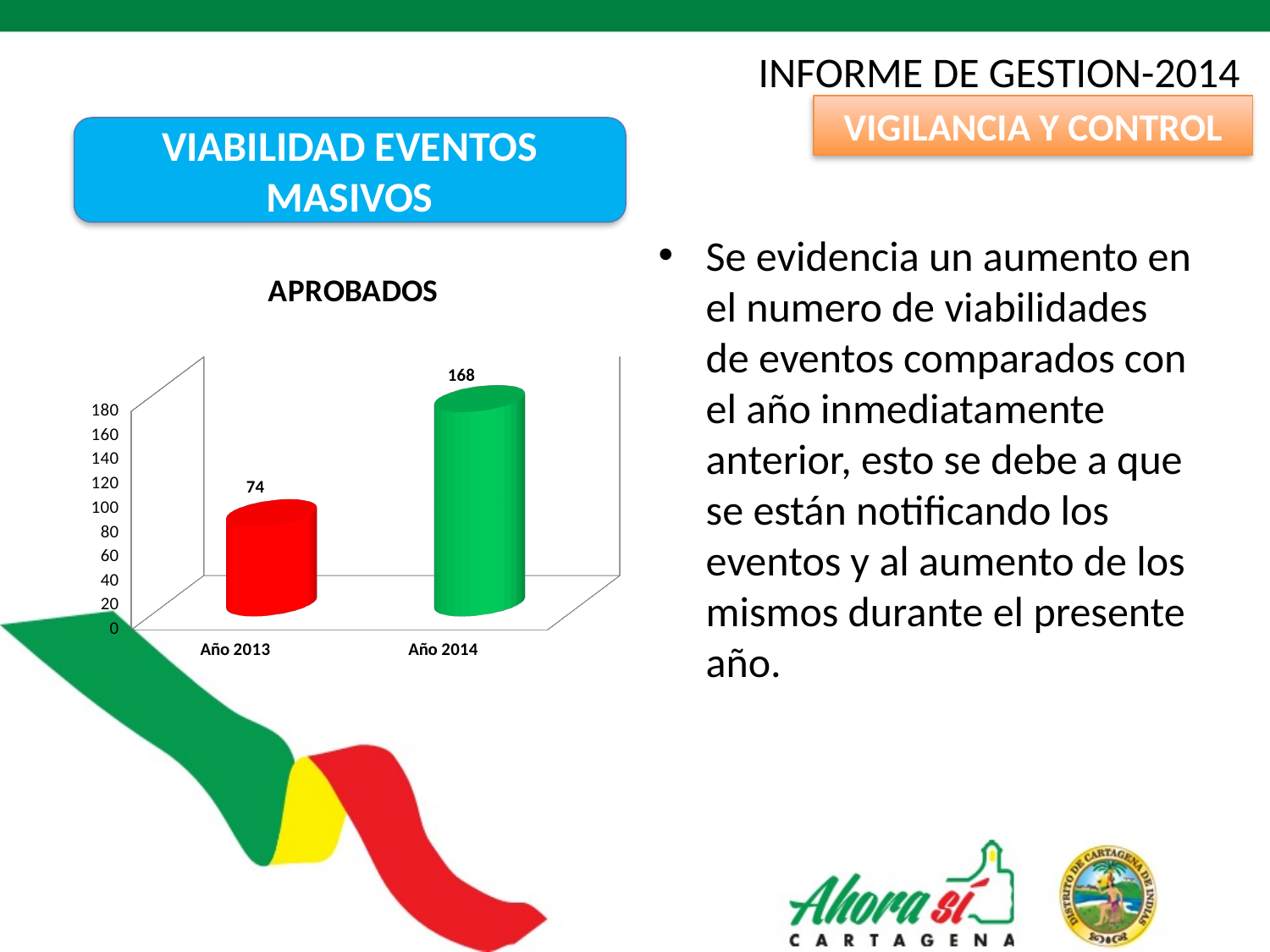
What is the value for Año 2014 in the APROBADOS chart? 168 Which year has the lowest value in the APROBADOS chart? Año 2013 Which is larger in the APROBADOS chart, the value for Año 2013 or Año 2014? Año 2014 What is the difference between the values for Año 2014 and Año 2013 in the APROBADOS chart? 94 What kind of chart is the APROBADOS chart? bar chart Is the value for Año 2014 in the APROBADOS chart greater or less than 140? greater What is the value for Año 2013 in the APROBADOS chart? 74 Is the value for Año 2013 in the APROBADOS chart greater or less than 100? less How many categories are shown in the APROBADOS chart? 2 Which year has the highest value in the APROBADOS chart? Año 2014 Do the values in the APROBADOS chart rise or fall from Año 2013 to Año 2014? rise What is the title of the chart on the slide? APROBADOS